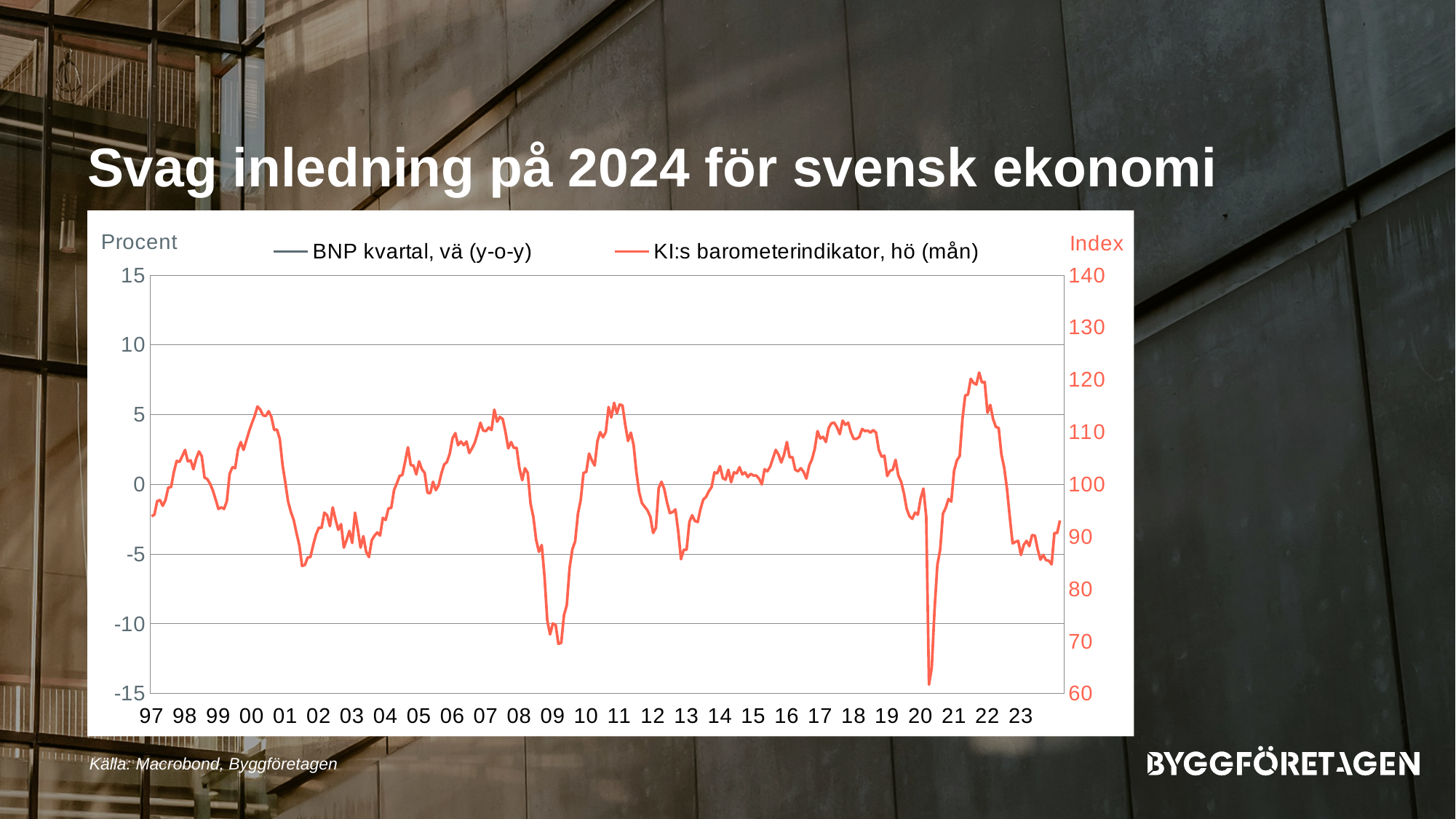
What is the highest value shown on the right-hand axis? 140 What is the title of the slide? Svag inledning på 2024 för svensk ekonomi Is the value of KI:s barometerindikator at its peak around 2000 greater or less than 110? greater How many series does the legend list? 2 Is the value of KI:s barometerindikator at its peak around 2021–22 greater or less than 110? greater Is the value of KI:s barometerindikator at its lowest point around 2009 greater or less than 80? less What kind of chart is shown on the slide? Line chart What is the label of the right-hand axis? Index Which is lower for KI:s barometerindikator: the trough around 2009 or the trough around 2020? The trough around 2020 How many year labels are shown on the x axis? 27